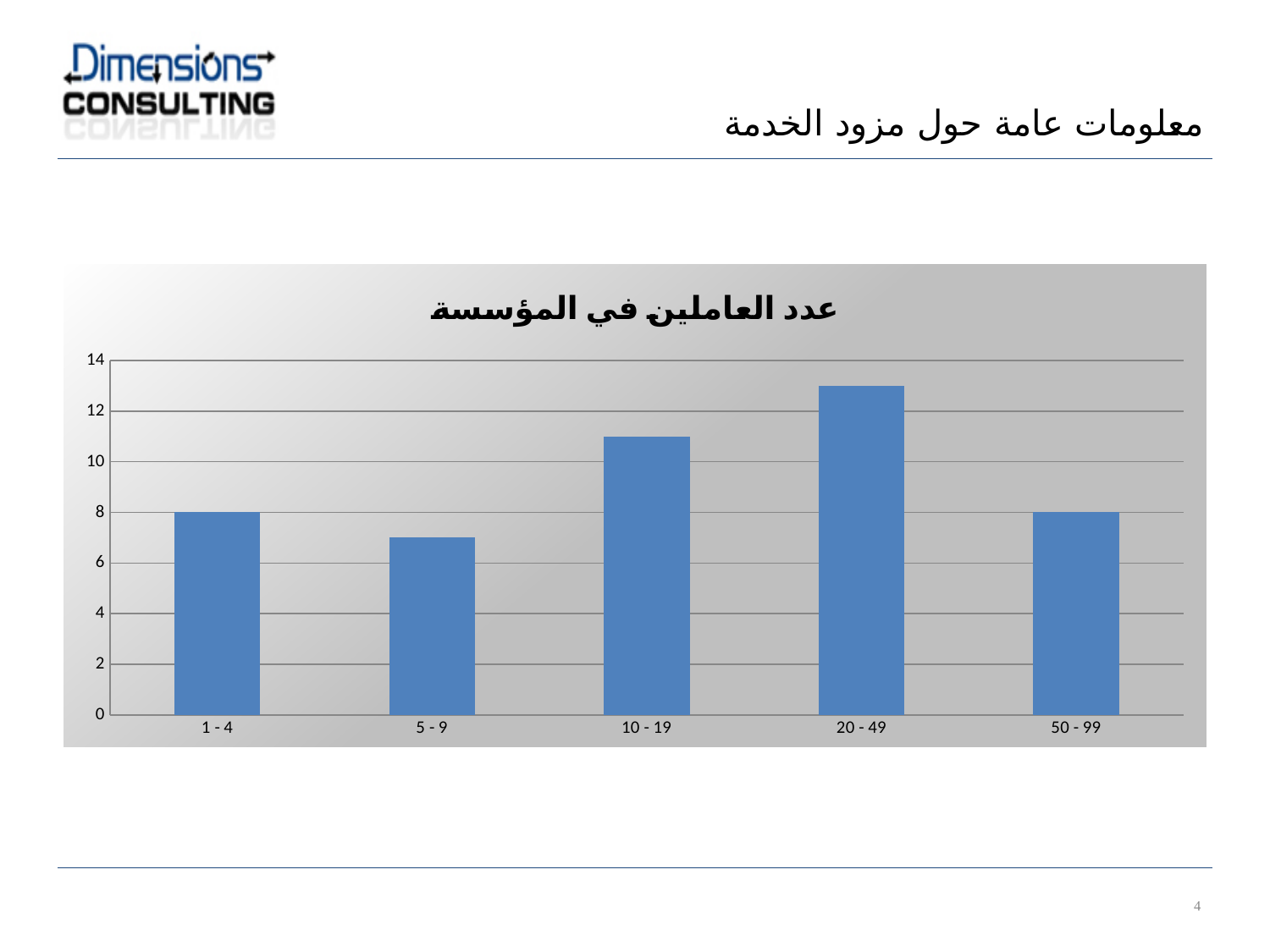
Which category has the lowest bar? 5 - 9 Is the value for 20 - 49 greater or less than 12? greater Is the value for 10 - 19 greater or less than 10? greater What is the title of the chart? عدد العاملين في المؤسسة Which category has the highest bar? 20 - 49 How many categories are shown on the x axis of the chart? 5 Which is larger, the value for 5 - 9 or the value for 1 - 4? 1 - 4 Which is larger, the value for 10 - 19 or the value for 20 - 49? 20 - 49 What is the value for the category 1 - 4? 8 What kind of chart is shown on the slide? bar chart Is the value for 5 - 9 greater or less than 8? less What is the value for the category 50 - 99? 8